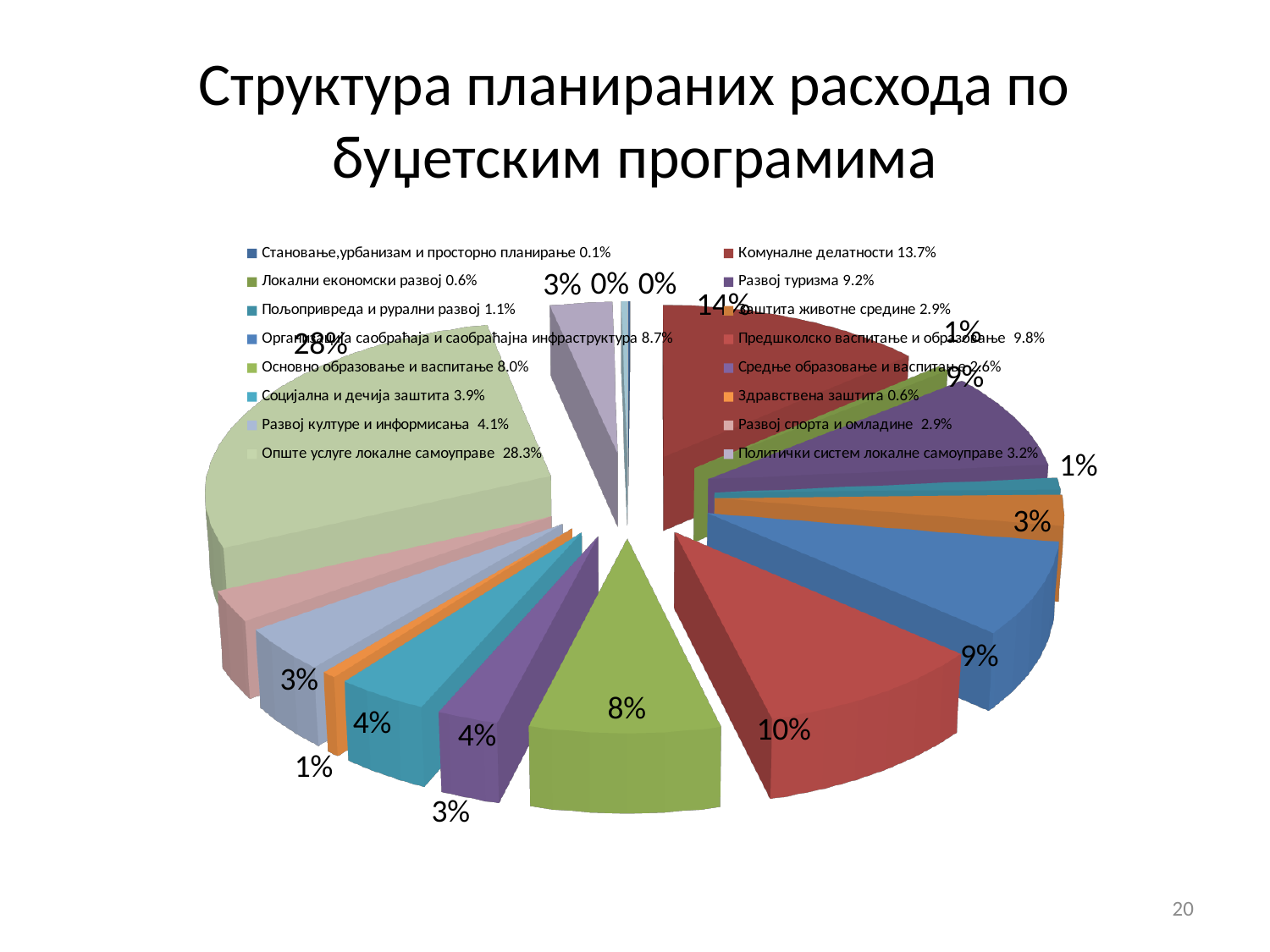
What percentage is shown in the legend for Развој туризма? 9.2% Which has a larger share: Комуналне делатности or Развој туризма? Комуналне делатности How many categories does the legend of the pie chart list? 16 What is the difference in percentage points between Опште услуге локалне самоуправе (28.3%) and Комуналне делатности (13.7%)? 14.6 What percentage is shown in the legend for Социјална и дечија заштита? 3.9% What kind of chart is shown on the slide? pie chart What is the title of the chart on the slide? Структура планираних расхода по буџетским програмима Which category has the largest share of planned expenditures? Опште услуге локалне самоуправе What percentage is shown in the legend for Здравствена заштита? 0.6% What percentage is shown in the legend for Комуналне делатности? 13.7% What percentage is shown in the legend for Предшколско васпитање и образовање? 9.8% Which category has the smallest share of planned expenditures? Становање,урбанизам и просторно планирање